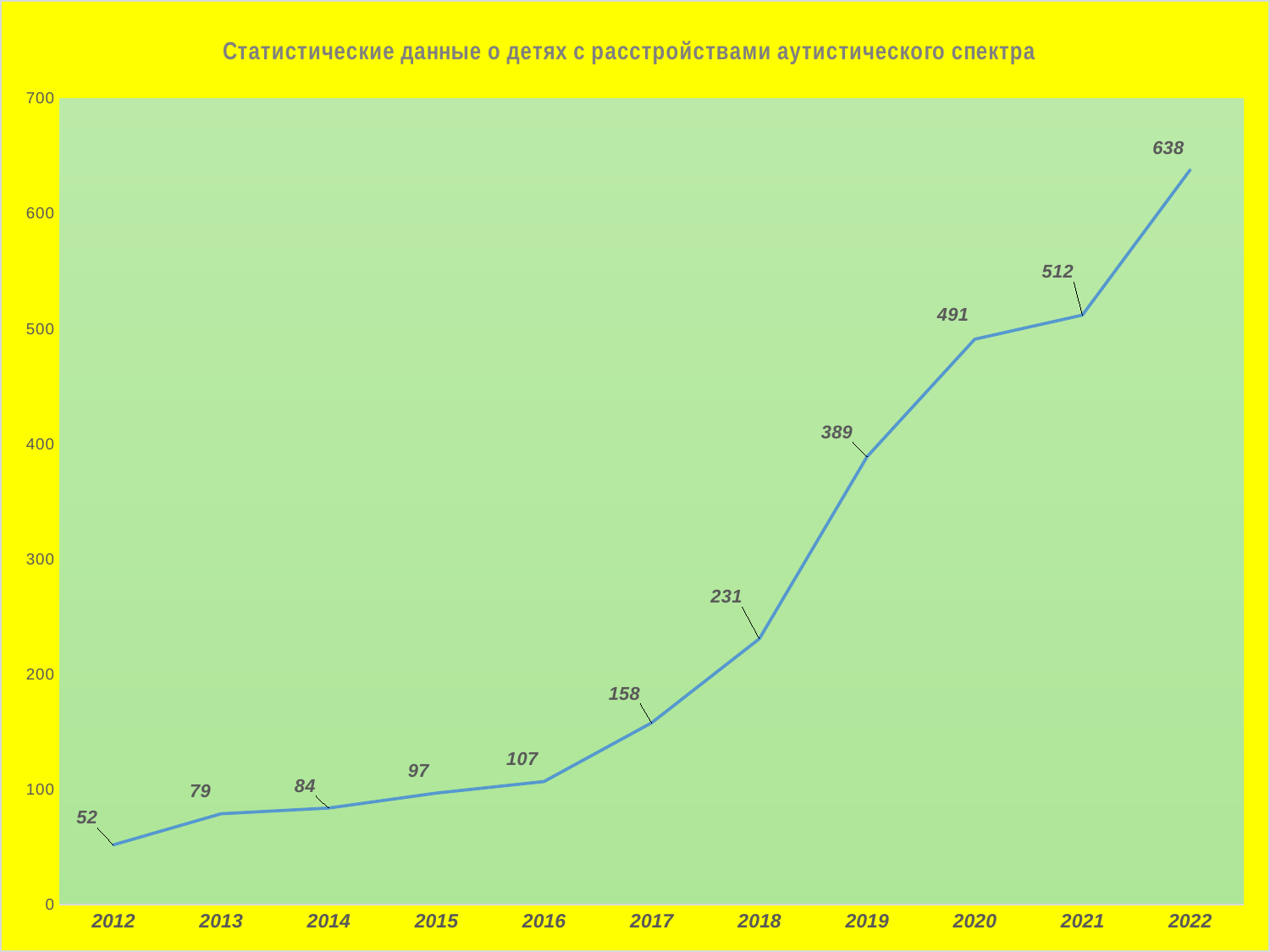
What is the difference between the values for 2022 and 2021? 126 What is the value for 2018? 231 Do the values rise or fall from 2012 to 2022? rise Is the value for 2019 greater or less than 300? greater What is the difference between the values for 2019 and 2018? 158 What is the value for 2012? 52 Which year has the highest value? 2022 Which year has the lowest value? 2012 How many years are shown on the x axis? 11 Which is larger, the value for 2016 or the value for 2017? 2017 What kind of chart is this? line chart What is the value for 2020? 491